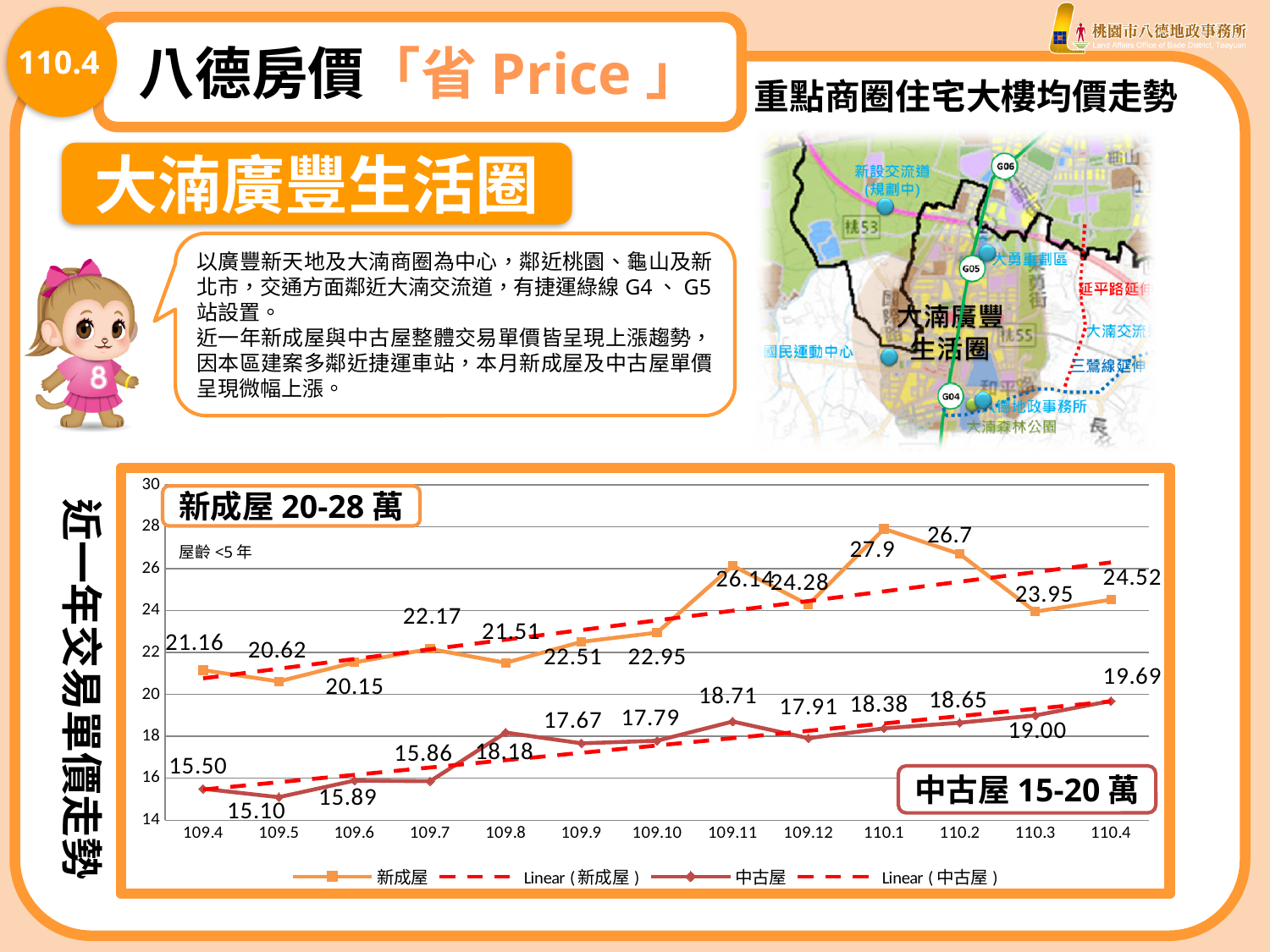
How many time points are shown on the x axis of the chart? 13 Which is larger for 新成屋: the value at 109.4 or the value at 109.5? 109.4 What is the difference between the 新成屋 values at 110.1 and 110.2? 1.2 Overall, does the 中古屋 series rise or fall from 109.4 to 110.4? rise In which month does the 中古屋 series reach its lowest value? 109.5 How many entries does the legend of the chart list? 4 What is the value of 新成屋 at 110.4? 24.52 What is the value of 中古屋 at 110.4? 19.69 Is the value of 中古屋 at 109.4 greater or less than 16? less In which month does the 新成屋 series reach its highest value? 110.1 What is the highest value of the 新成屋 series? 27.9 What kind of chart is shown at the bottom of the slide? line chart